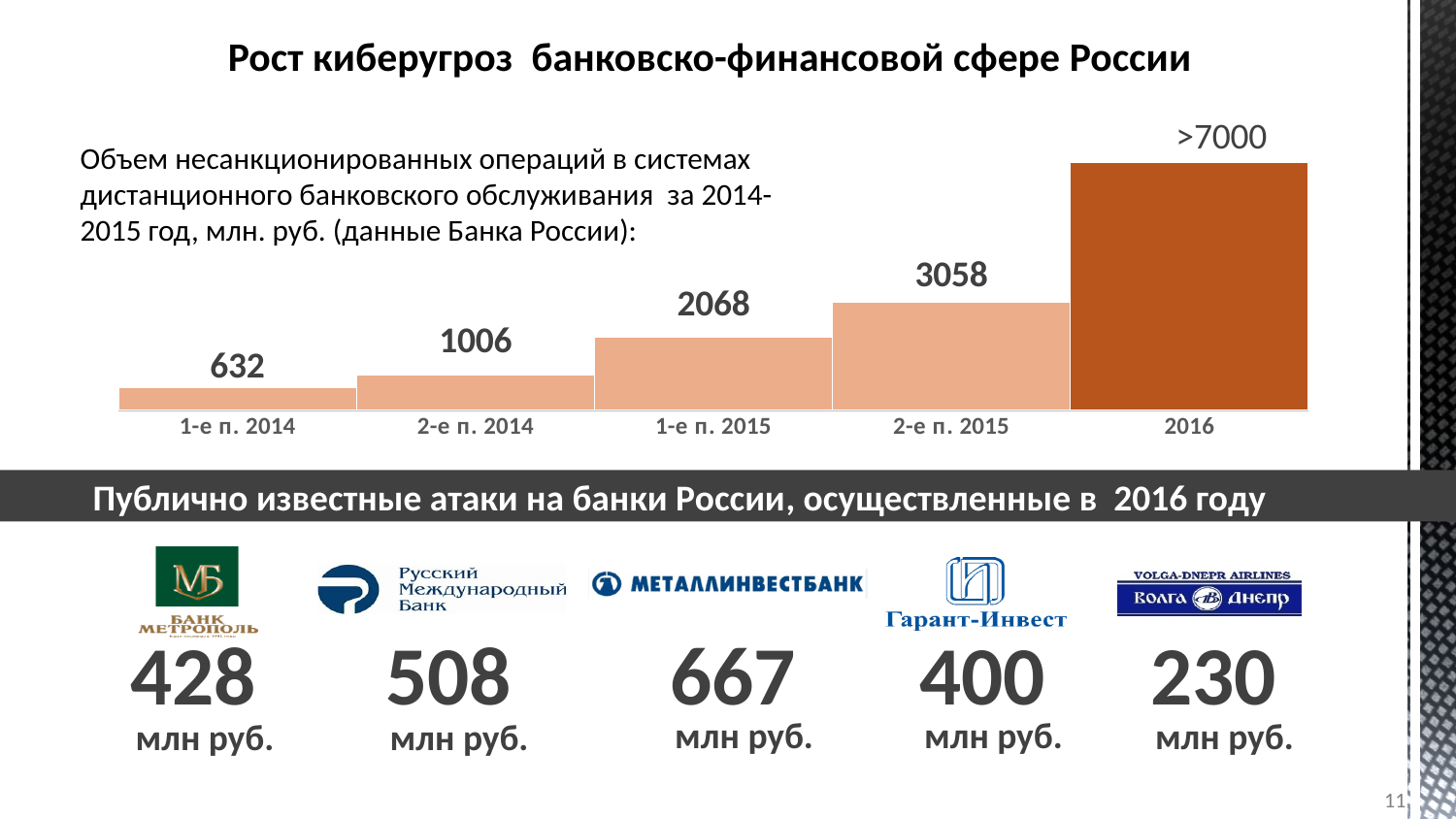
Which category has the lowest bar? 1-е п. 2014 What is the value for 2-е п. 2015? 3058 How many categories are shown on the x axis of the chart? 5 Which is larger, the value for 2-е п. 2014 or the value for 1-е п. 2015? 1-е п. 2015 What is the value for 1-е п. 2014? 632 Do the values rise or fall from left to right along the x axis? rise What kind of chart is shown on the slide? bar chart What is the difference between the values for 2-е п. 2015 and 1-е п. 2015? 990 What label is printed above the bar for 2016? >7000 What is the value for 1-е п. 2015? 2068 What is the value for 2-е п. 2014? 1006 Which category has the highest bar? 2016